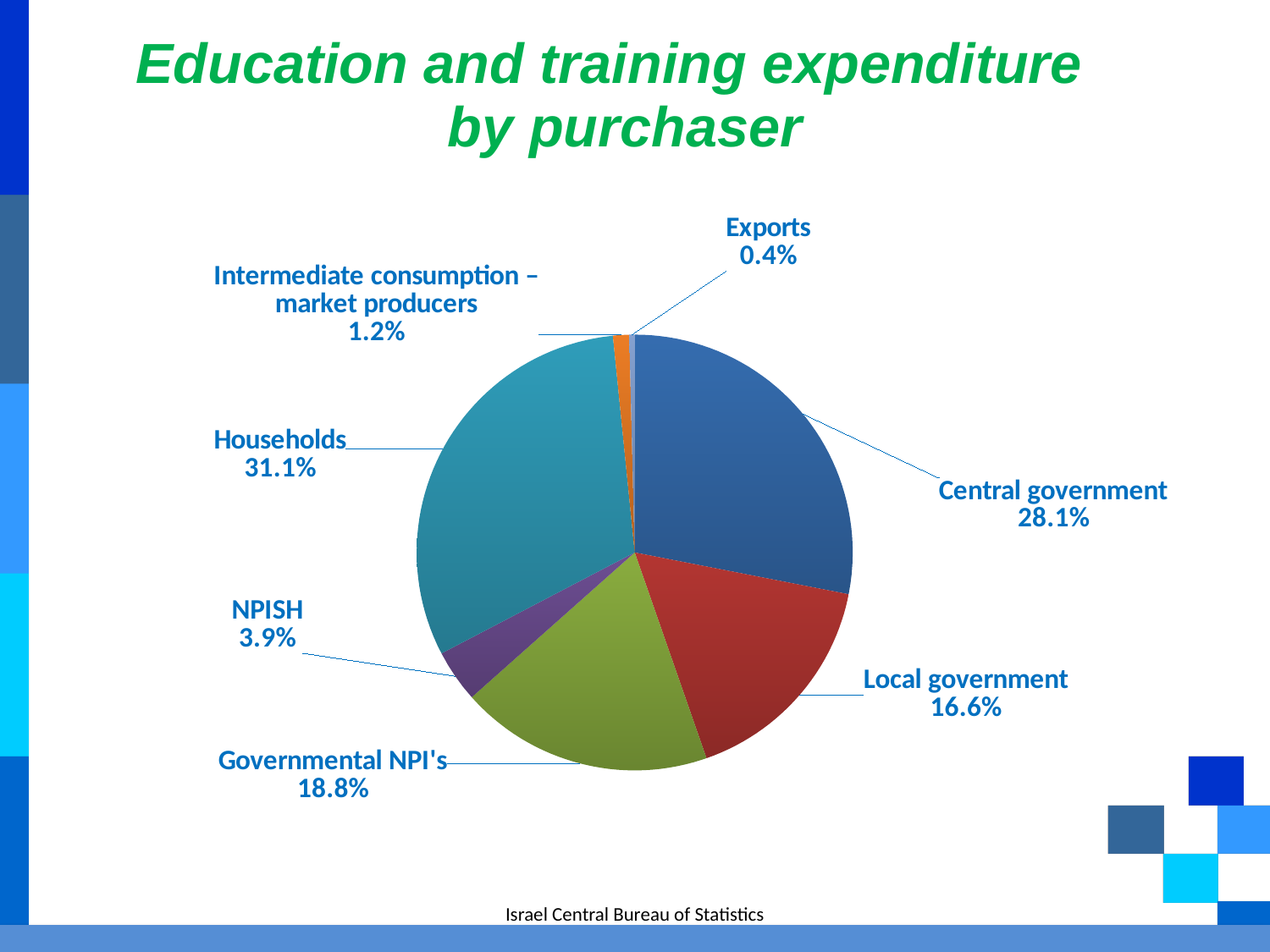
What share of education and training expenditure is attributed to Exports? 0.4% Which purchaser has the largest share of education and training expenditure? Households Which purchaser has the smallest share of education and training expenditure? Exports What share of education and training expenditure is attributed to Central government? 28.1% What type of chart is shown on the slide? Pie chart What is the title of the chart on the slide? Education and training expenditure by purchaser What share of education and training expenditure is attributed to Households? 31.1% What share of education and training expenditure is attributed to Governmental NPI's? 18.8% How many purchaser categories are shown in the pie chart? 7 What is the difference in percentage points between the Households share and the Central government share? 3.0 percentage points What share of education and training expenditure is attributed to Local government? 16.6% Which has a larger share: Governmental NPI's or Local government? Governmental NPI's